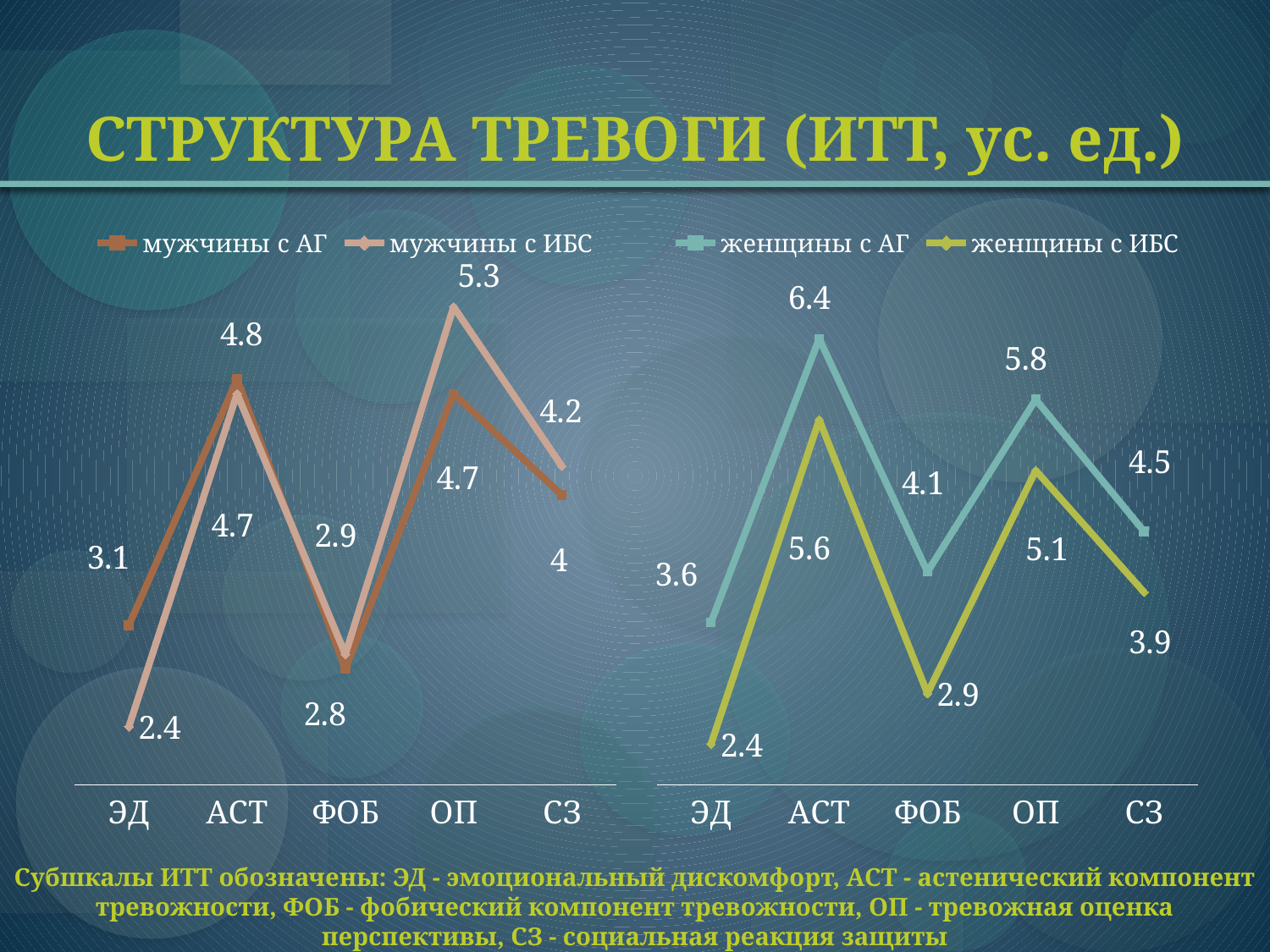
How many series does the legend of the right chart (women) list? 2 On the left chart (men), what is the value for мужчины с ИБС at ОП? 5.3 What type of chart is used on the left side of the slide (men)? Line chart On the right chart (women), at which subscale does женщины с АГ reach its highest value? АСТ On the right chart (women), what is the value for женщины с ИБС at ЭД? 2.4 On the right chart (women), what is the value for женщины с АГ at АСТ? 6.4 On the right chart (women), what is the difference between женщины с АГ and женщины с ИБС at ФОБ? 1.2 On the left chart (men), at which subscale does мужчины с ИБС have its lowest value? ЭД On the right chart (women), what is the value for женщины с ИБС at СЗ? 3.9 How many subscales are shown on the x axis of the left chart (men)? 5 On the left chart (men), what is the value for мужчины с АГ at АСТ? 4.8 On the left chart (men), which series has the larger value at ОП: мужчины с АГ or мужчины с ИБС? мужчины с ИБС